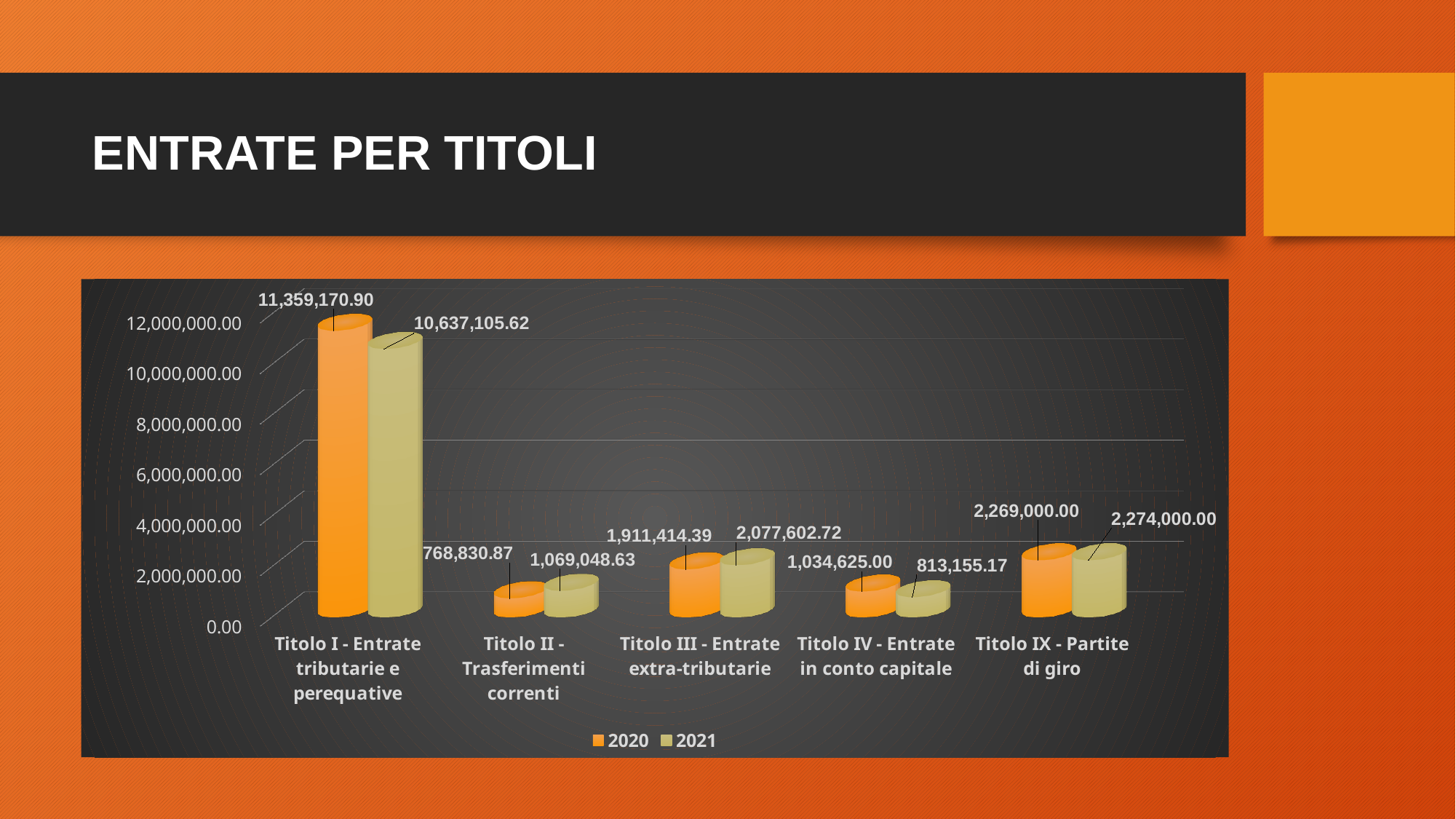
What is the 2021 value for Titolo II - Trasferimenti correnti? 1,069,048.63 What is the 2020 value for Titolo I - Entrate tributarie e perequative? 11,359,170.90 For Titolo III - Entrate extra-tributarie, which year has the larger value, 2020 or 2021? 2021 What kind of chart is shown on the slide? Bar chart What is the 2020 value for Titolo IX - Partite di giro? 2,269,000.00 What is the difference between the 2021 and 2020 values for Titolo IX - Partite di giro? 5,000.00 Which category has the highest 2021 value? Titolo I - Entrate tributarie e perequative What is the difference between the 2020 and 2021 values for Titolo I - Entrate tributarie e perequative? 722,065.28 What is the 2021 value for Titolo IV - Entrate in conto capitale? 813,155.17 How many categories are shown on the x axis? 5 Which category has the lowest 2020 value? Titolo II - Trasferimenti correnti How many series does the legend list? 2